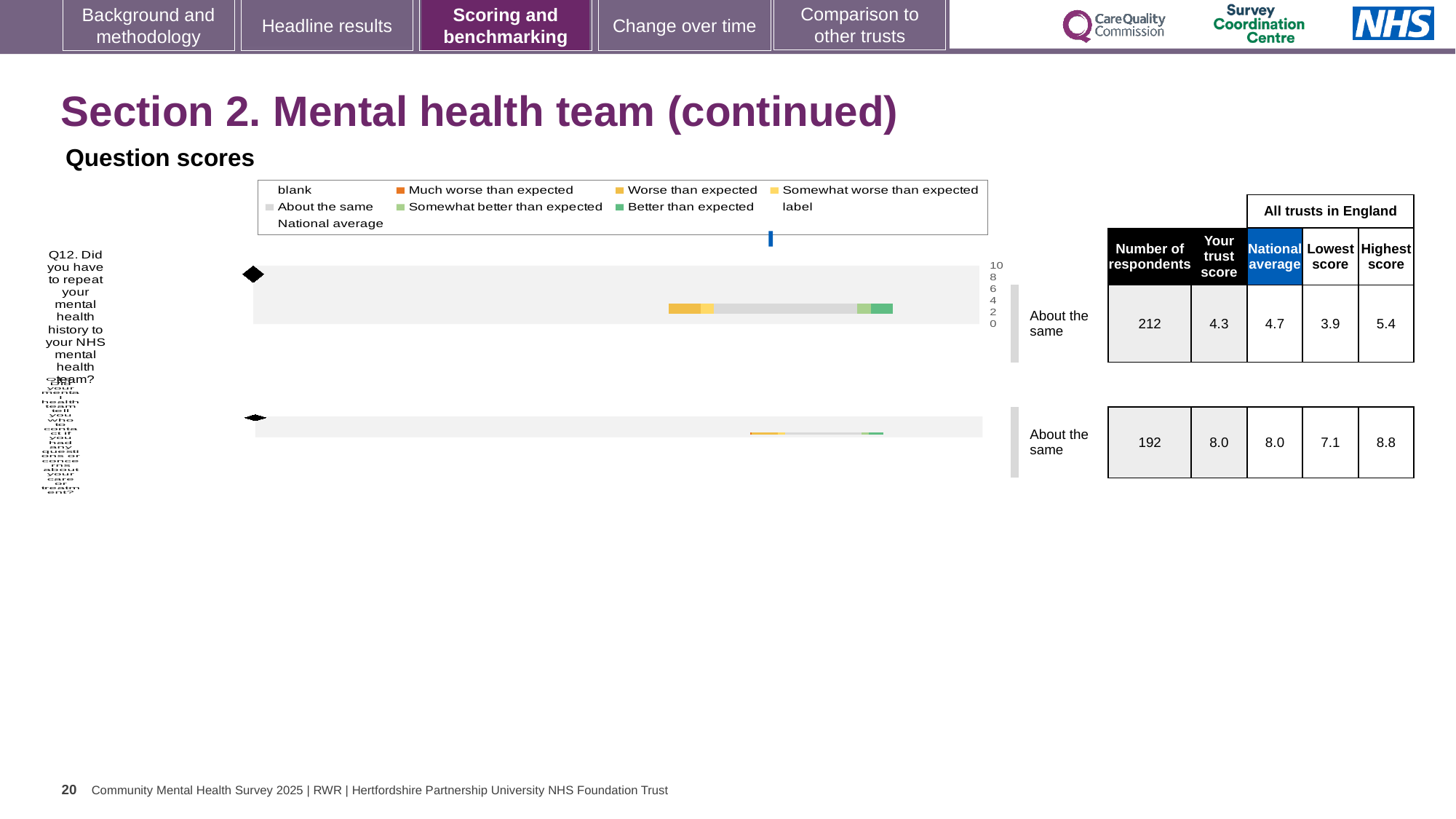
How many respondents answered Q12? 212 What is the lowest score among all trusts in England for Q12? 3.9 How many question rows are plotted on this slide? 2 What is the trust's score for Q12 (Did you have to repeat your mental health history to your NHS mental health team?)? 4.3 What benchmark category is shown next to the Q12 bar? About the same For Q12, which is larger: the trust's score or the national average? National average What is the national average score for Q12? 4.7 For Q12, what is the difference between the highest and lowest scores among all trusts in England? 1.5 For the second (lower) question row on the slide, what is the trust's score? 8.0 What is the highest score among all trusts in England for Q12? 5.4 For the second (lower) question row on the slide, how many respondents are there? 192 For the second (lower) question row, what is the difference between the highest score (8.8) and the lowest score (7.1)? 1.7